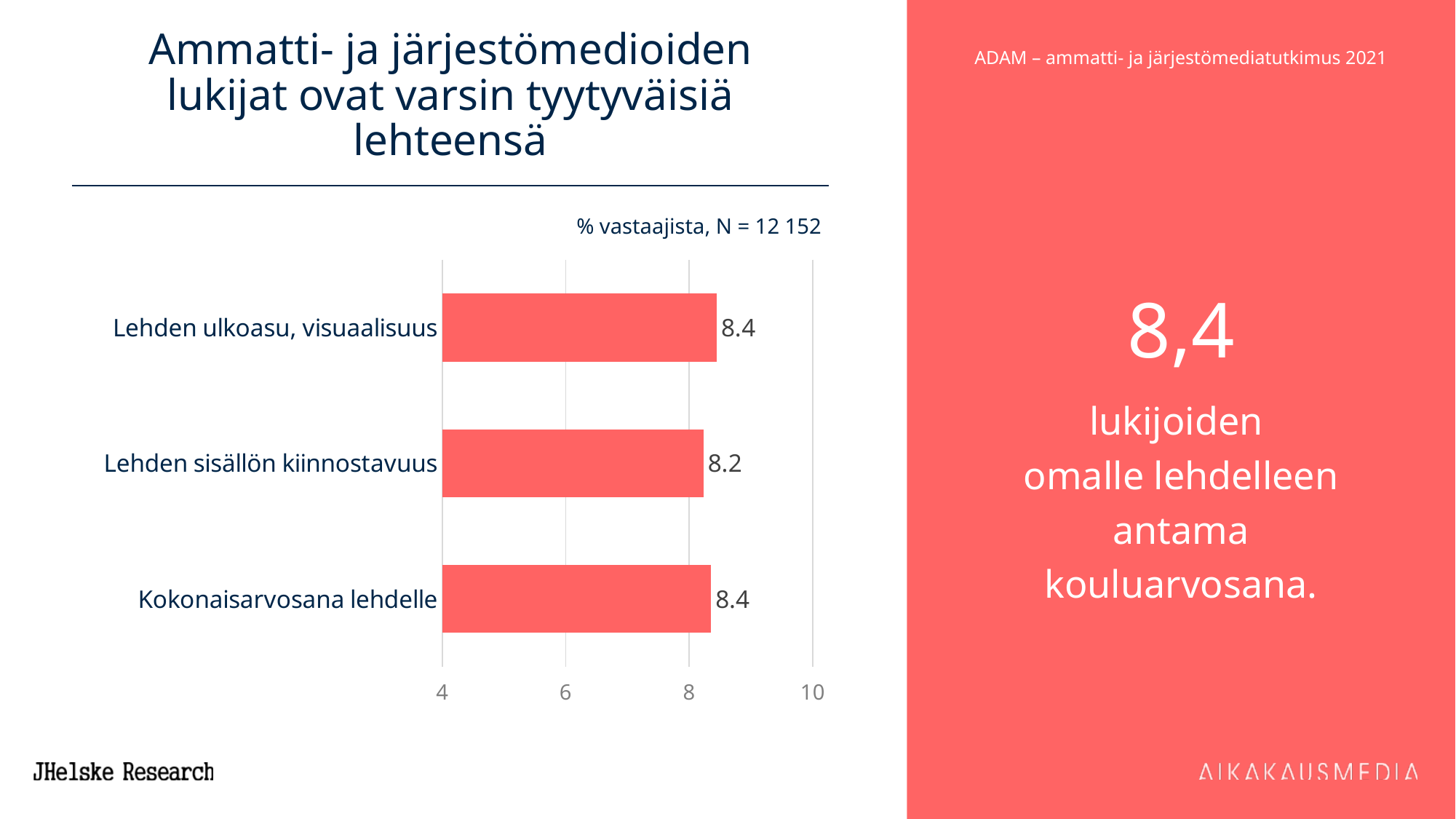
What is the lowest value shown on the x axis of the chart? 4 Which category has the lowest value? Lehden sisällön kiinnostavuus How many categories are shown in the chart? 3 Which is larger, the value for Kokonaisarvosana lehdelle or the value for Lehden sisällön kiinnostavuus? Kokonaisarvosana lehdelle What is the difference between the values for Lehden ulkoasu, visuaalisuus and Lehden sisällön kiinnostavuus? 0.2 What is the value for Lehden sisällön kiinnostavuus? 8.2 What kind of chart is shown on the slide? bar chart What is the sample size (N) stated above the chart? 12 152 What is the value for Kokonaisarvosana lehdelle? 8.4 Is the value for Lehden sisällön kiinnostavuus greater or less than 8? greater What is the value for Lehden ulkoasu, visuaalisuus? 8.4 Is the value for Kokonaisarvosana lehdelle greater or less than 10? less